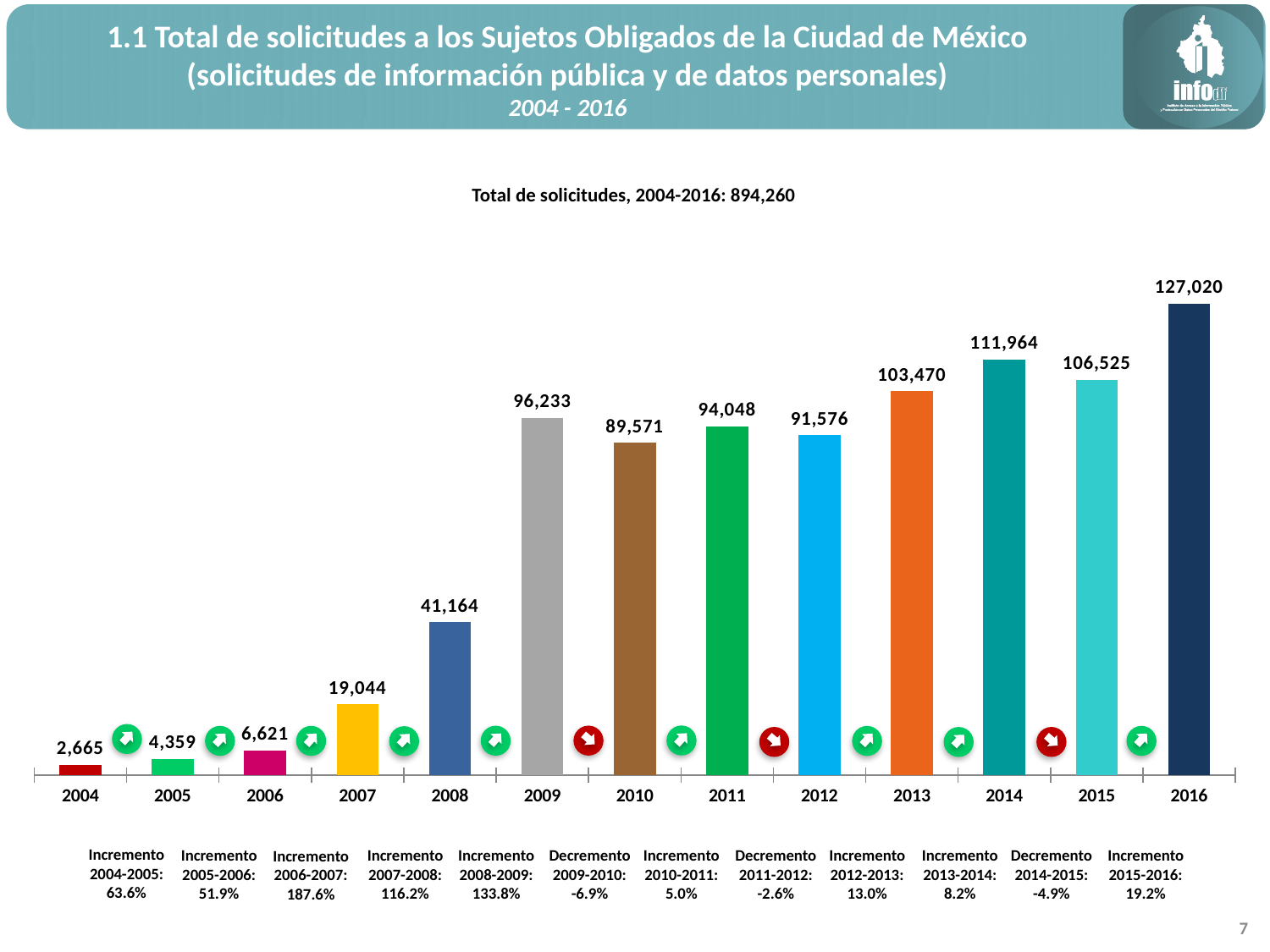
What is the number of solicitudes for 2008? 41,164 Which year has a larger value, 2011 or 2012? 2011 What kind of chart is shown on the slide? Bar chart How many years are shown on the x axis of the chart? 13 What is the number of solicitudes for 2010? 89,571 What is the number of solicitudes for 2016? 127,020 What is the difference between the values for 2009 and 2010? 6,662 Which year has the lowest number of solicitudes? 2004 Which year has the highest number of solicitudes? 2016 What is the difference between the values for 2016 and 2015? 20,495 What is the total of solicitudes for 2004-2016 stated above the chart? 894,260 Do the values generally rise or fall from 2004 to 2016? Rise